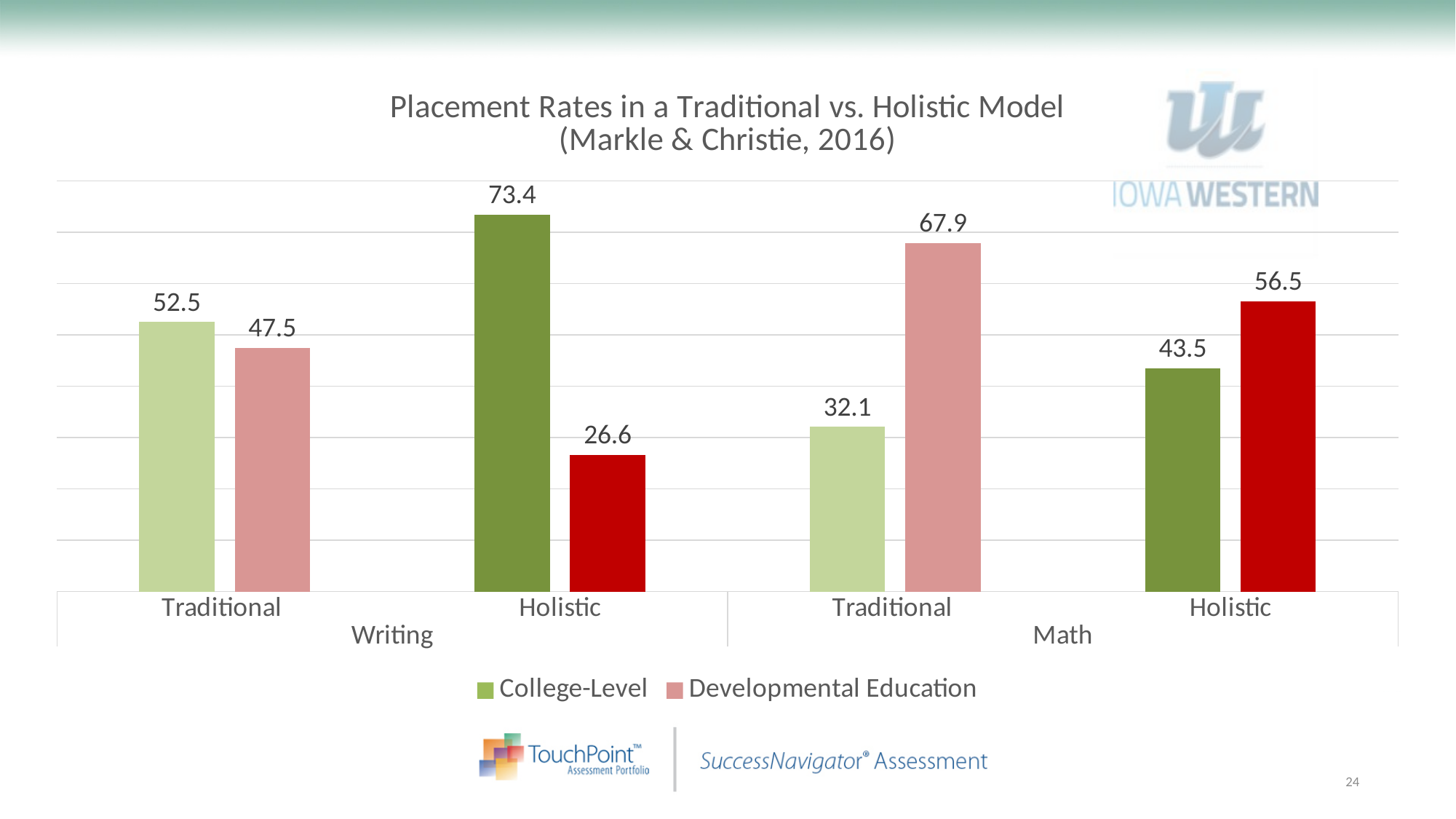
Which bar has the highest value on the chart? College-Level, Holistic, Writing (73.4) How many series does the legend list? 2 What is the College-Level placement rate for the Traditional model in Writing? 52.5 Which bar has the lowest value on the chart? Developmental Education, Holistic, Writing (26.6) What kind of chart is shown on the slide? Bar chart What is the difference between the Developmental Education rates for the Traditional and Holistic models in Math? 11.4 What is the difference between the College-Level rates for the Holistic and Traditional models in Writing? 20.9 What is the title of the chart? Placement Rates in a Traditional vs. Holistic Model (Markle & Christie, 2016) What is the College-Level placement rate for the Holistic model in Math? 43.5 What is the Developmental Education placement rate for the Traditional model in Math? 67.9 What is the Developmental Education placement rate for the Holistic model in Writing? 26.6 In Math, which is larger for the Traditional model: the College-Level rate or the Developmental Education rate? Developmental Education